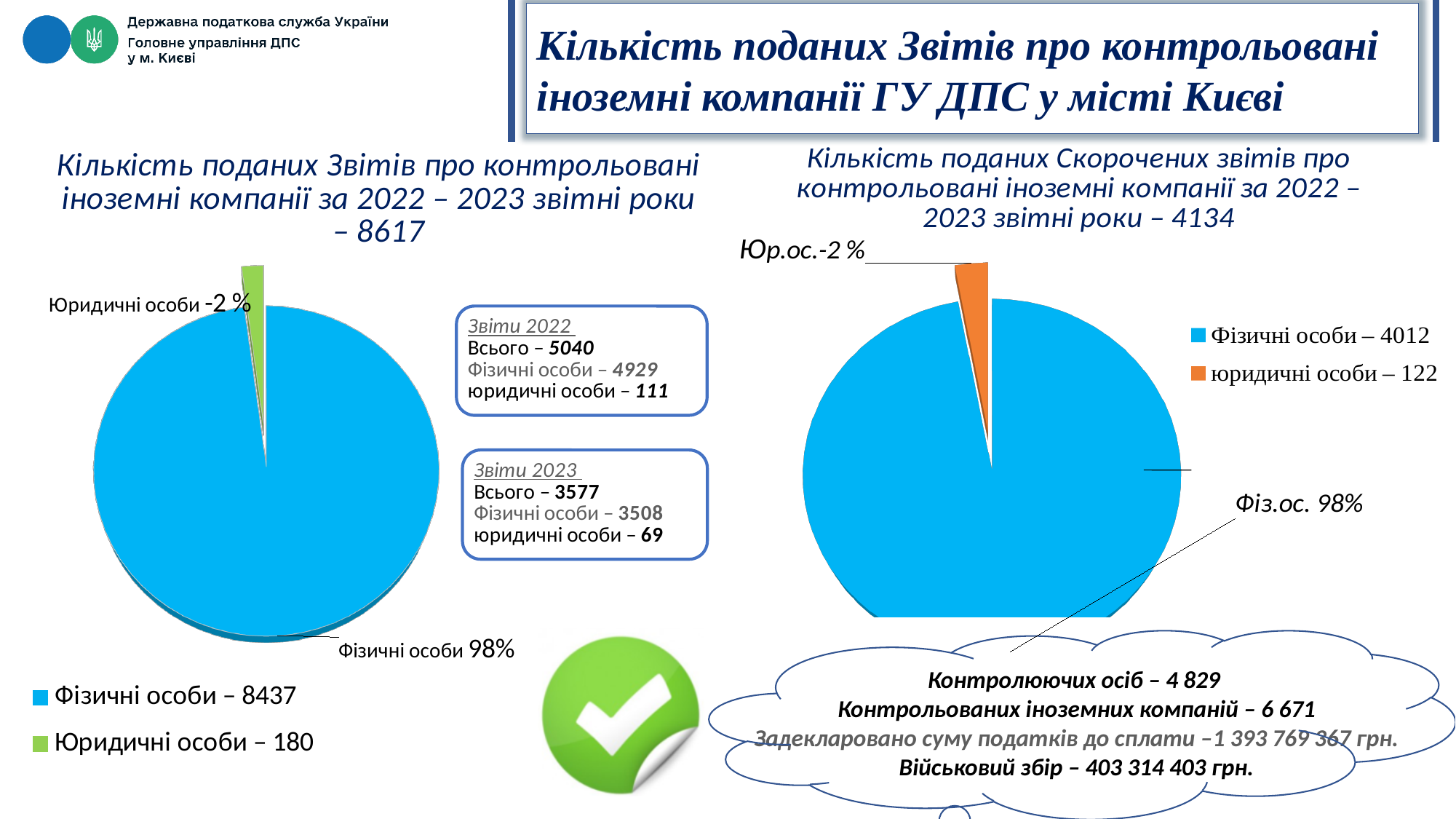
On the left pie chart, which category is the largest? Фізичні особи On the right pie chart, which category is the smallest? юридичні особи How many categories does the right pie chart show? 2 On the right pie chart, what is the value for Фізичні особи? 4012 On the left pie chart, what is the value for Юридичні особи? 180 What type of chart is used on the left side of the slide? Pie chart On the right pie chart, what share of the pie do юридичні особи hold? 2 % On the left pie chart, what is the value for Фізичні особи? 8437 On the left pie chart, what share of the pie do Фізичні особи hold? 98% On the right pie chart, what is the value for юридичні особи? 122 On the right pie chart, what is the difference between the values for Фізичні особи and юридичні особи? 3890 On the left pie chart, what is the difference between the values for Фізичні особи and Юридичні особи? 8257